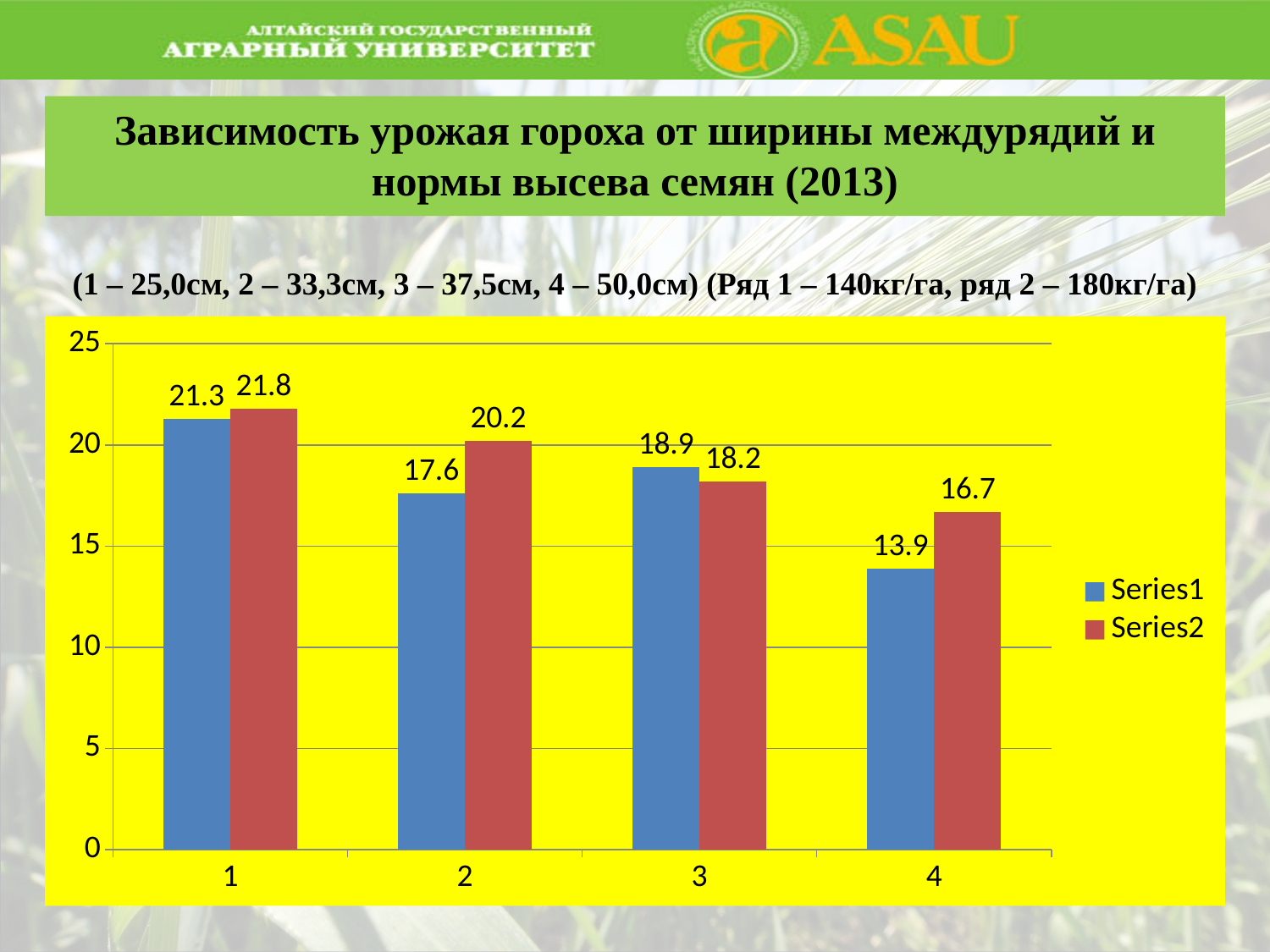
Which is larger for category 3, Series1 or Series2? Series1 What is the difference between Series2 and Series1 for category 4? 2.8 How many series does the legend list? 2 Is the value of Series1 for category 2 greater or less than 20? less What is the value of Series1 for category 1? 21.3 What colour are the Series2 bars? red What is the value of Series2 for category 2? 20.2 What kind of chart is shown on the slide? bar chart What is the value of Series1 for category 4? 13.9 Which category has the lowest Series1 value? 4 Which category has the highest Series2 value? 1 How many categories are shown on the x axis? 4